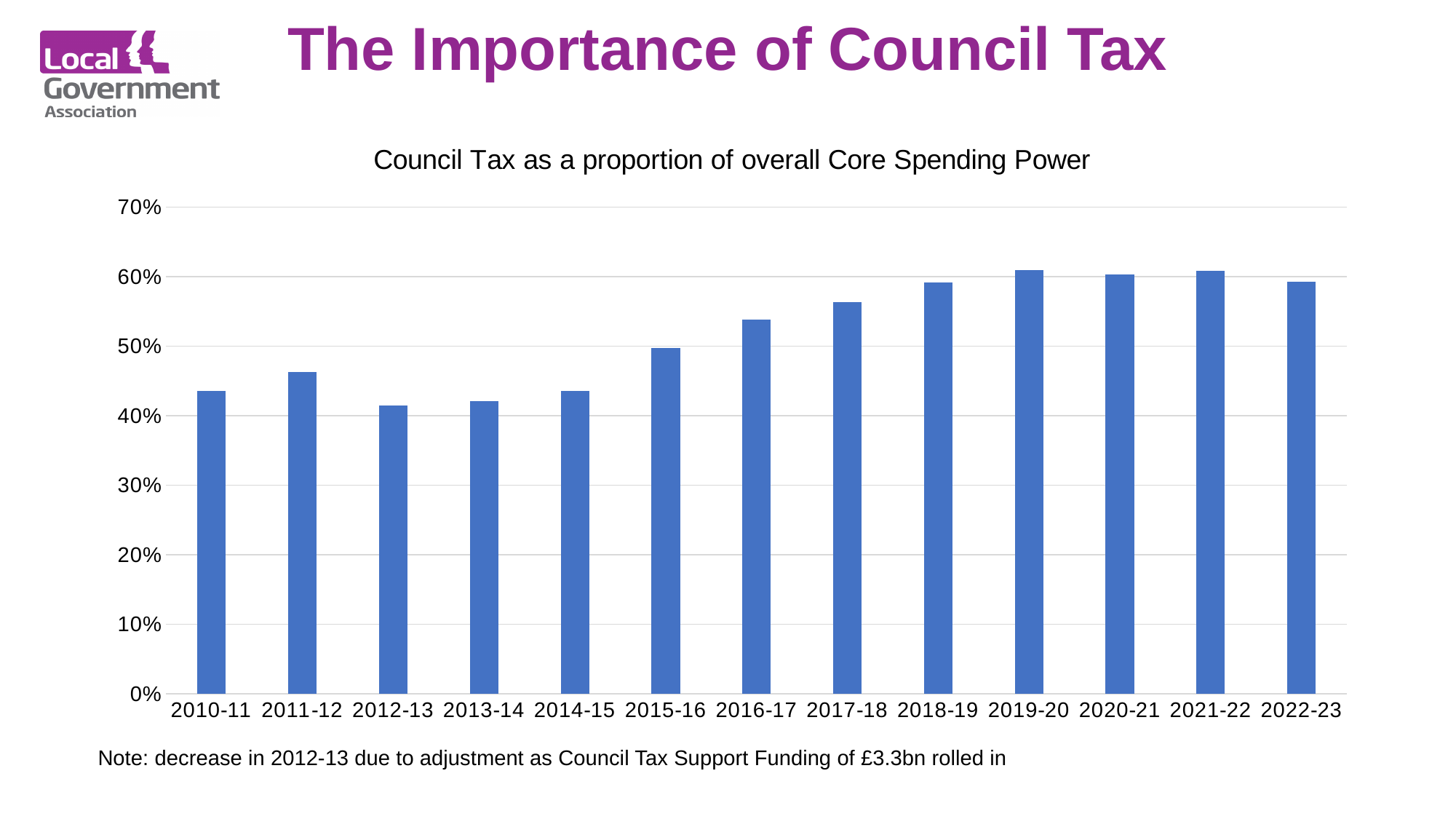
Which is larger, the value for 2011-12 or the value for 2016-17? 2016-17 Is the value for 2016-17 greater or less than 50%? greater According to the note below the chart, what caused the decrease in 2012-13? Adjustment as Council Tax Support Funding of £3.3bn rolled in How many financial years are shown on the x axis of the chart? 13 Is the value for 2022-23 greater or less than 50%? greater What kind of chart is shown on the slide? Bar chart Is the value for 2011-12 greater or less than 50%? less Which is larger, the value for 2010-11 or the value for 2018-19? 2018-19 What is the title of the chart? Council Tax as a proportion of overall Core Spending Power Overall, do the values rise or fall from 2010-11 to 2022-23? Rise